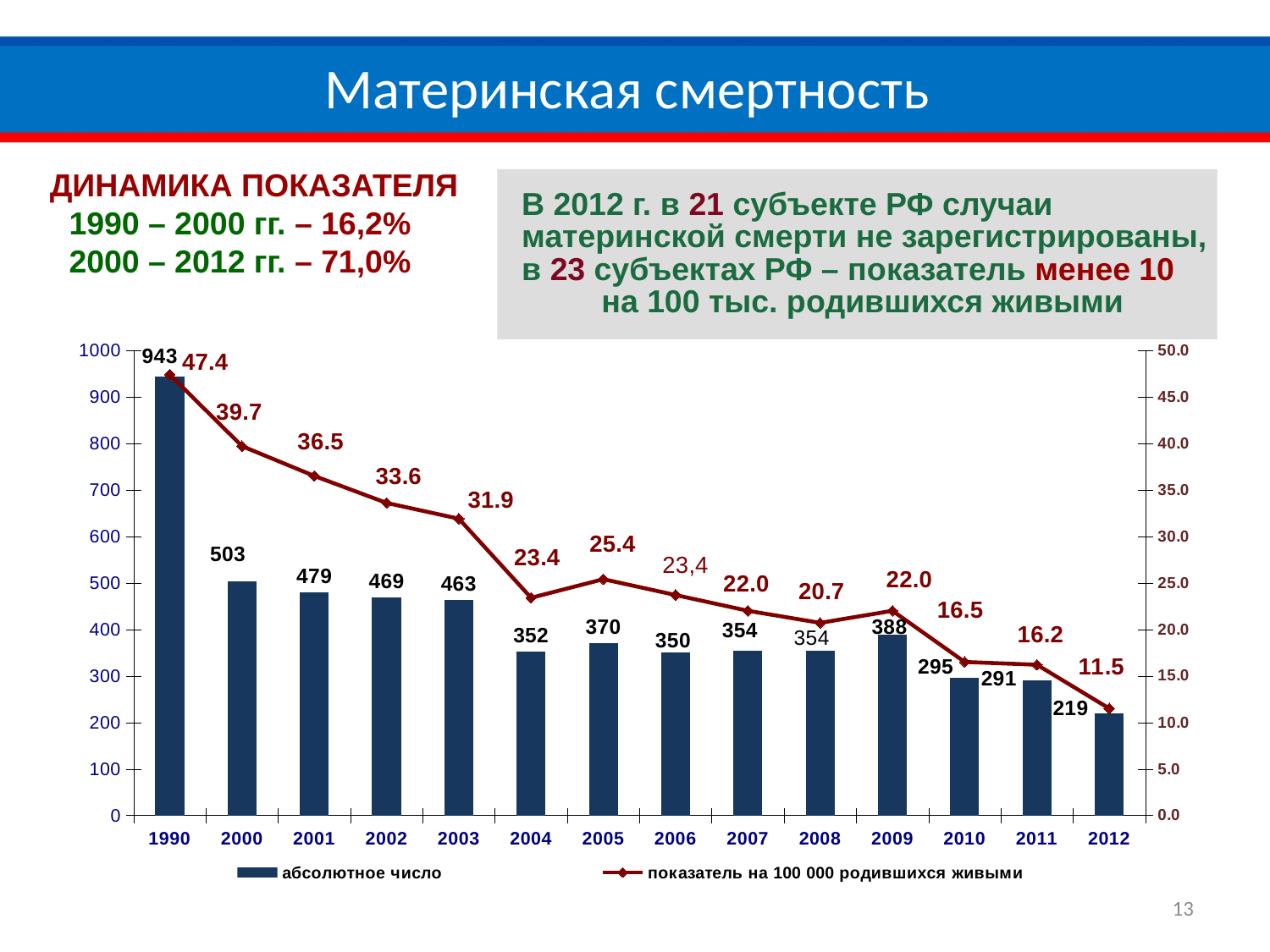
How many years are shown on the x axis of the chart? 14 Which is larger, the absolute number for 2005 or for 2006? 2005 What is the value of the indicator per 100 000 live births (показатель на 100 000 родившихся живыми) for 2012? 11.5 Which year has the lowest absolute number of maternal deaths? 2012 What is the difference between the absolute numbers for 1990 and 2000? 440 How many series does the chart legend list? 2 Which year has the highest indicator per 100 000 live births? 1990 What is the indicator per 100 000 live births for 2003? 31.9 What is the absolute number shown for 2009? 388 Does the indicator per 100 000 live births generally rise or fall from 1990 to 2012? fall What kind of chart is used to show the absolute number series? bar chart What is the absolute number (абсолютное число) of maternal deaths shown for 1990? 943